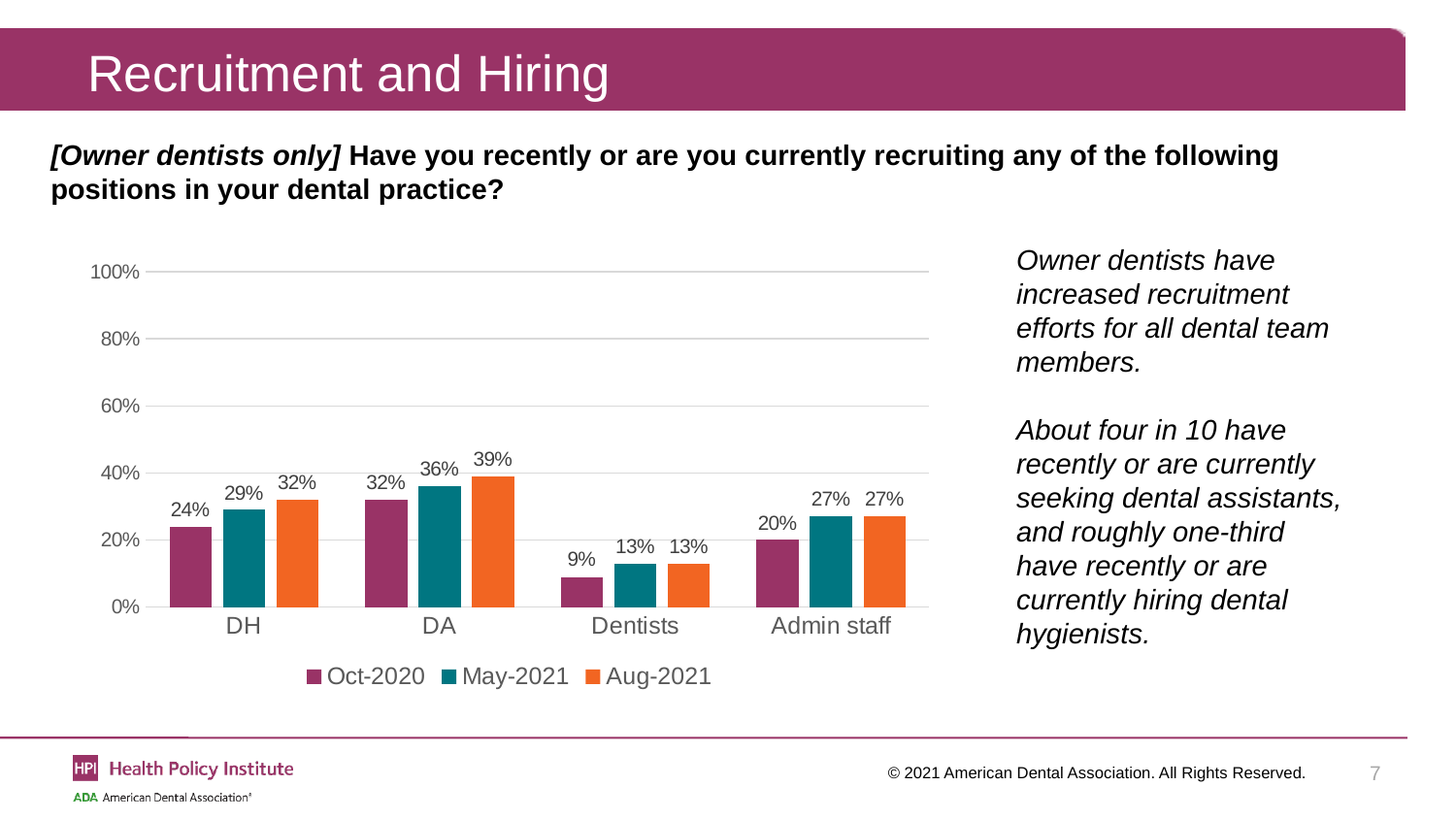
How many categories are shown on the x axis? 4 Is the Aug-2021 value for DA greater or less than 20%? greater What is the difference between the Aug-2021 and Oct-2020 values for DH? 8% Which series is shown in orange in the legend? Aug-2021 What is the Oct-2020 value for Dentists? 9% How many series does the legend list? 3 Which category has the lowest Oct-2020 value? Dentists Which category has the highest Aug-2021 value? DA What is the Aug-2021 value for DA? 39% What is the May-2021 value for Admin staff? 27% Which is larger: the May-2021 value for DH or the May-2021 value for Admin staff? DH What kind of chart is shown on the slide? Bar chart